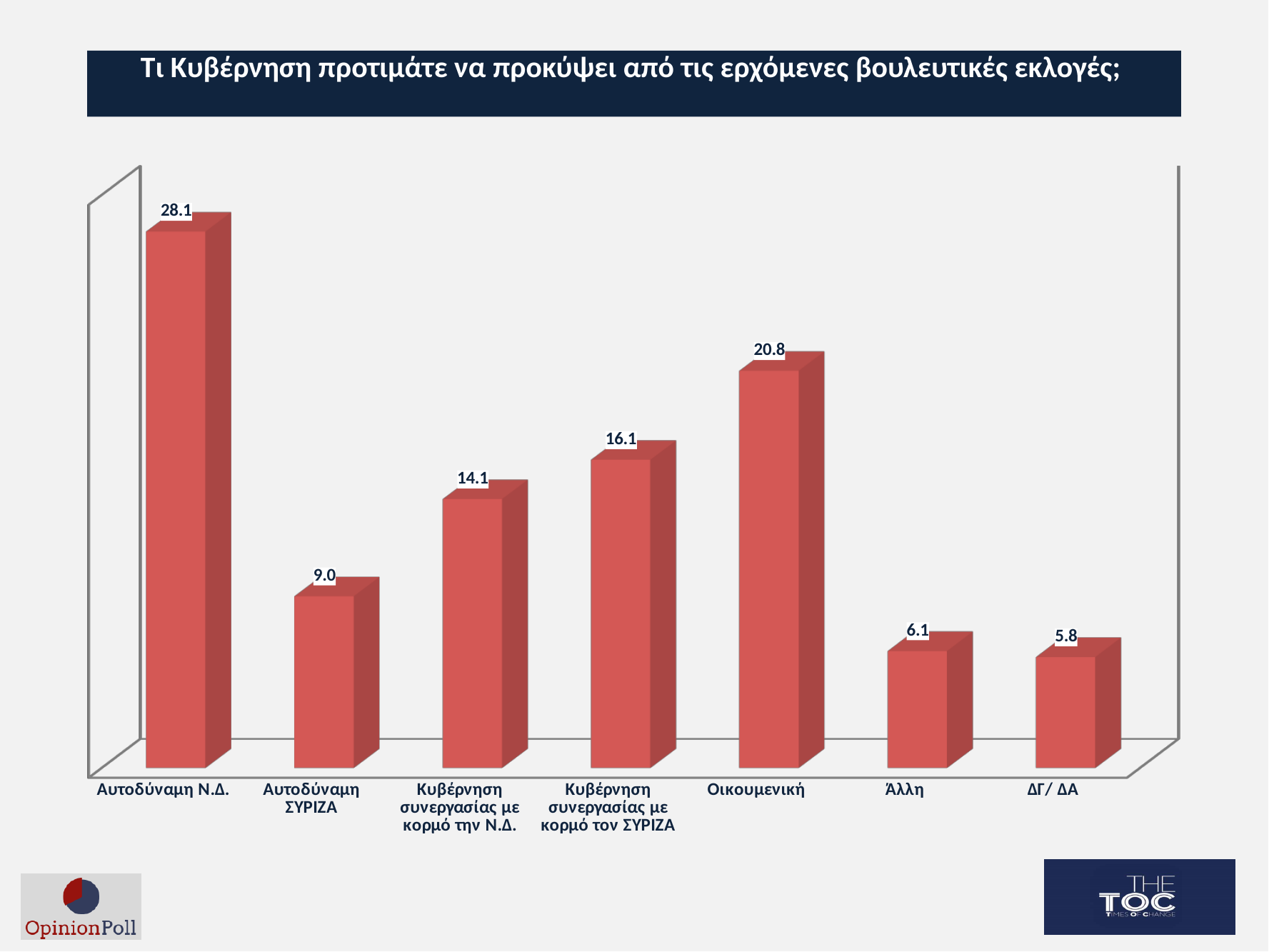
What is the difference between the values for Κυβέρνηση συνεργασίας με κορμό τον ΣΥΡΙΖΑ and Κυβέρνηση συνεργασίας με κορμό την Ν.Δ.? 2.0 What kind of chart is shown on the slide? Bar chart What is the value for Οικουμενική? 20.8 What is the value for Αυτοδύναμη Ν.Δ.? 28.1 What is the difference between the values for Αυτοδύναμη Ν.Δ. and Αυτοδύναμη ΣΥΡΙΖΑ? 19.1 What is the value for ΔΓ/ ΔΑ? 5.8 Which category has the lowest value? ΔΓ/ ΔΑ What is the title of the chart? Τι Κυβέρνηση προτιμάτε να προκύψει από τις ερχόμενες βουλευτικές εκλογές; How many categories are shown in the chart? 7 Which is larger, the value for Οικουμενική or the value for Κυβέρνηση συνεργασίας με κορμό την Ν.Δ.? Οικουμενική Which category has the highest value? Αυτοδύναμη Ν.Δ. What is the value for Κυβέρνηση συνεργασίας με κορμό τον ΣΥΡΙΖΑ? 16.1